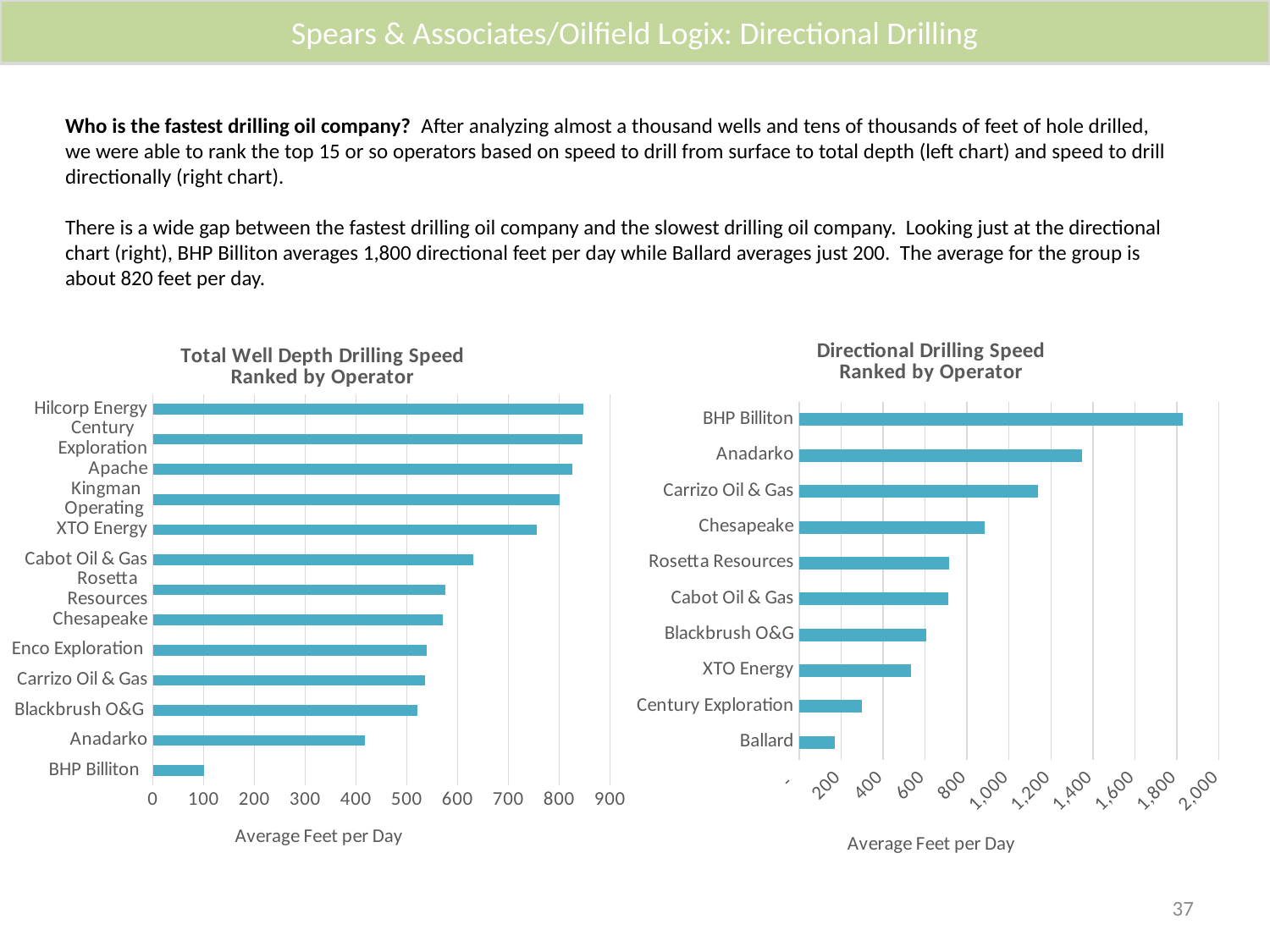
In the Total Well Depth Drilling Speed chart on the left, is the value for BHP Billiton greater or less than 200? less How many operators are shown in the Directional Drilling Speed chart on the right? 10 In the Directional Drilling Speed chart on the right, is the value for Anadarko greater or less than 1,200? greater In the Directional Drilling Speed chart on the right, which operator has the lowest value? Ballard What is the x-axis title of the Total Well Depth Drilling Speed chart on the left? Average Feet per Day In the Total Well Depth Drilling Speed chart on the left, which operator has the lowest value? BHP Billiton In the Directional Drilling Speed chart on the right, which operator has the highest value? BHP Billiton How many operators are shown in the Total Well Depth Drilling Speed chart on the left? 13 In the Total Well Depth Drilling Speed chart on the left, is the value for XTO Energy greater or less than 700? greater What type of chart is the Directional Drilling Speed chart on the right? bar chart In the Directional Drilling Speed chart on the right, which is larger, the value for Anadarko or the value for Carrizo Oil & Gas? Anadarko